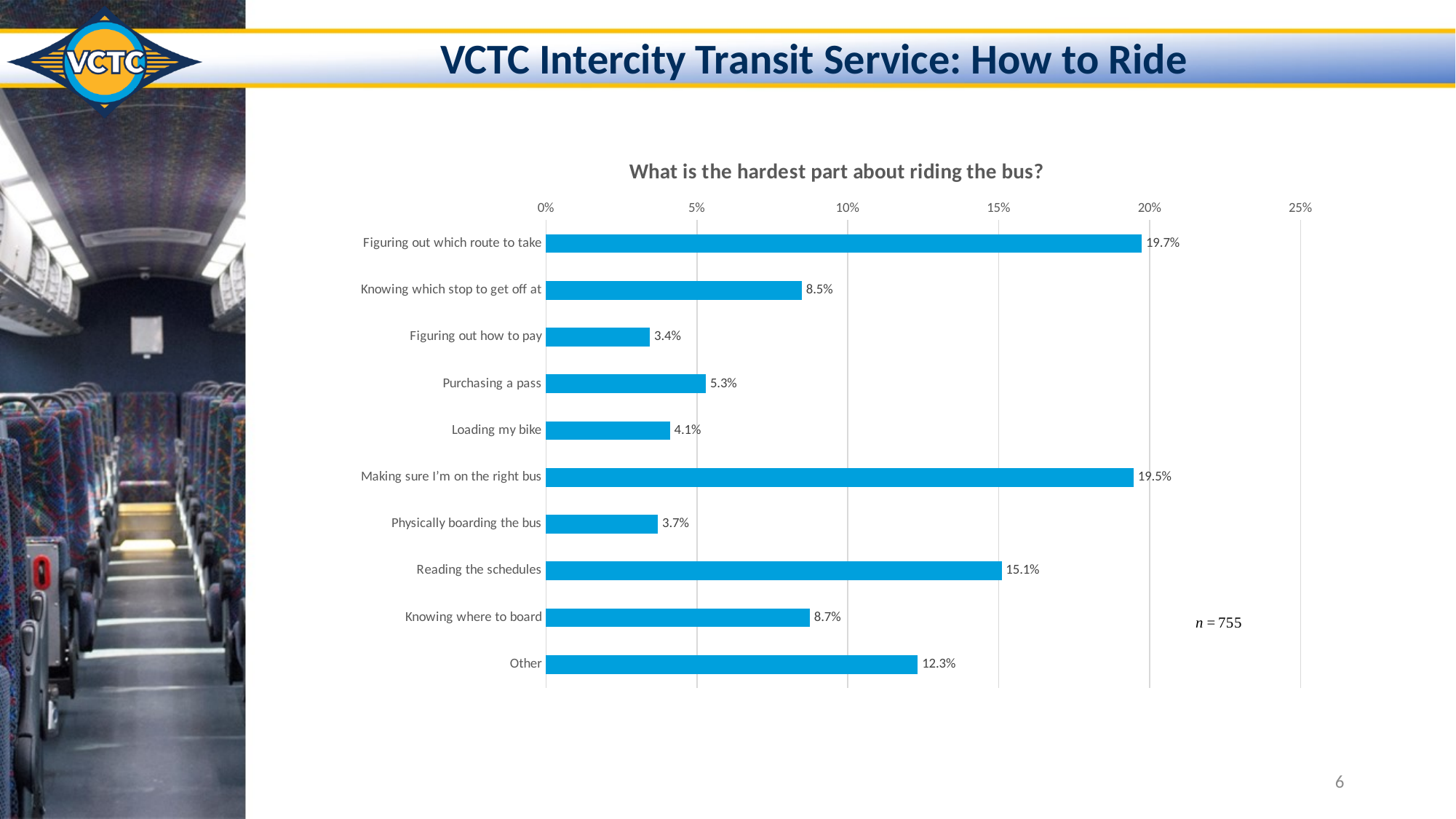
What kind of chart is shown on the slide? Bar chart What is the difference between 'Figuring out which route to take' and 'Making sure I'm on the right bus'? 0.2% What percentage of respondents said figuring out which route to take is the hardest part about riding the bus? 19.7% What is the value for 'Knowing where to board'? 8.7% Which is larger: 'Purchasing a pass' or 'Loading my bike'? Purchasing a pass Which category has the lowest value in the chart? Figuring out how to pay What is the difference between 'Knowing where to board' and 'Knowing which stop to get off at'? 0.2% What is the title of the chart? What is the hardest part about riding the bus? What is the value for 'Reading the schedules'? 15.1% Is the value for 'Other' greater or less than 10%? greater How many categories are shown in the chart? 10 What sample size (n) is noted on the chart? n = 755